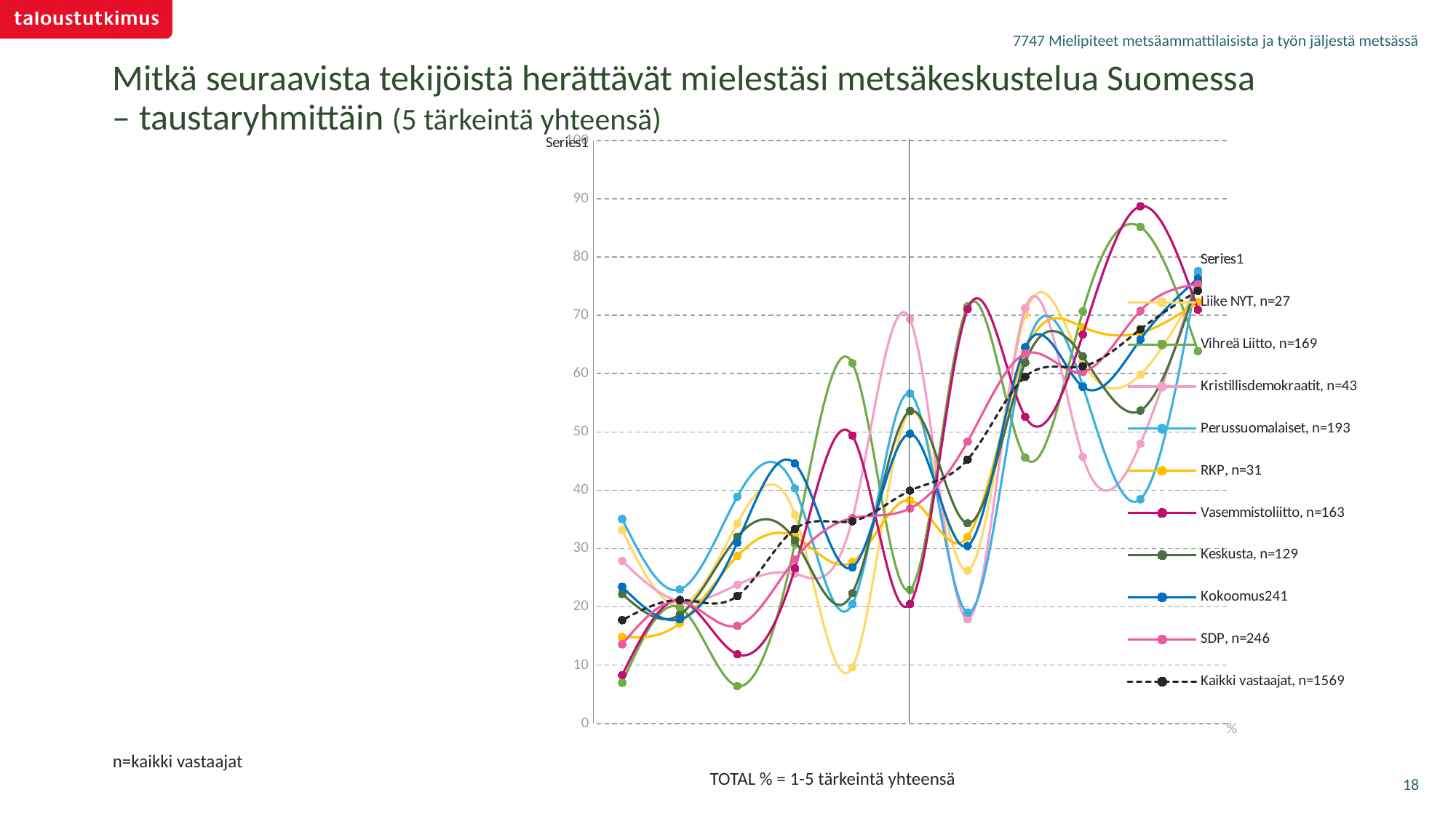
Is the lowest point on the chart greater or less than 10? less Is the last (rightmost) value for Kaikki vastaajat greater or less than 70? greater Is the highest point reached by Vasemmistoliitto greater or less than 80? greater What is the highest value shown on the y axis? 100 Do the values for Kaikki vastaajat generally rise or fall from left to right along the x axis? rise According to the legend, what is the sample size (n) for SDP? 246 Which legend entry is drawn as a dashed black line? Kaikki vastaajat, n=1569 Which legend group has the smallest sample size (n)? Liike NYT, n=27 What kind of chart is shown on the slide? line chart How many entries does the chart legend list? 11